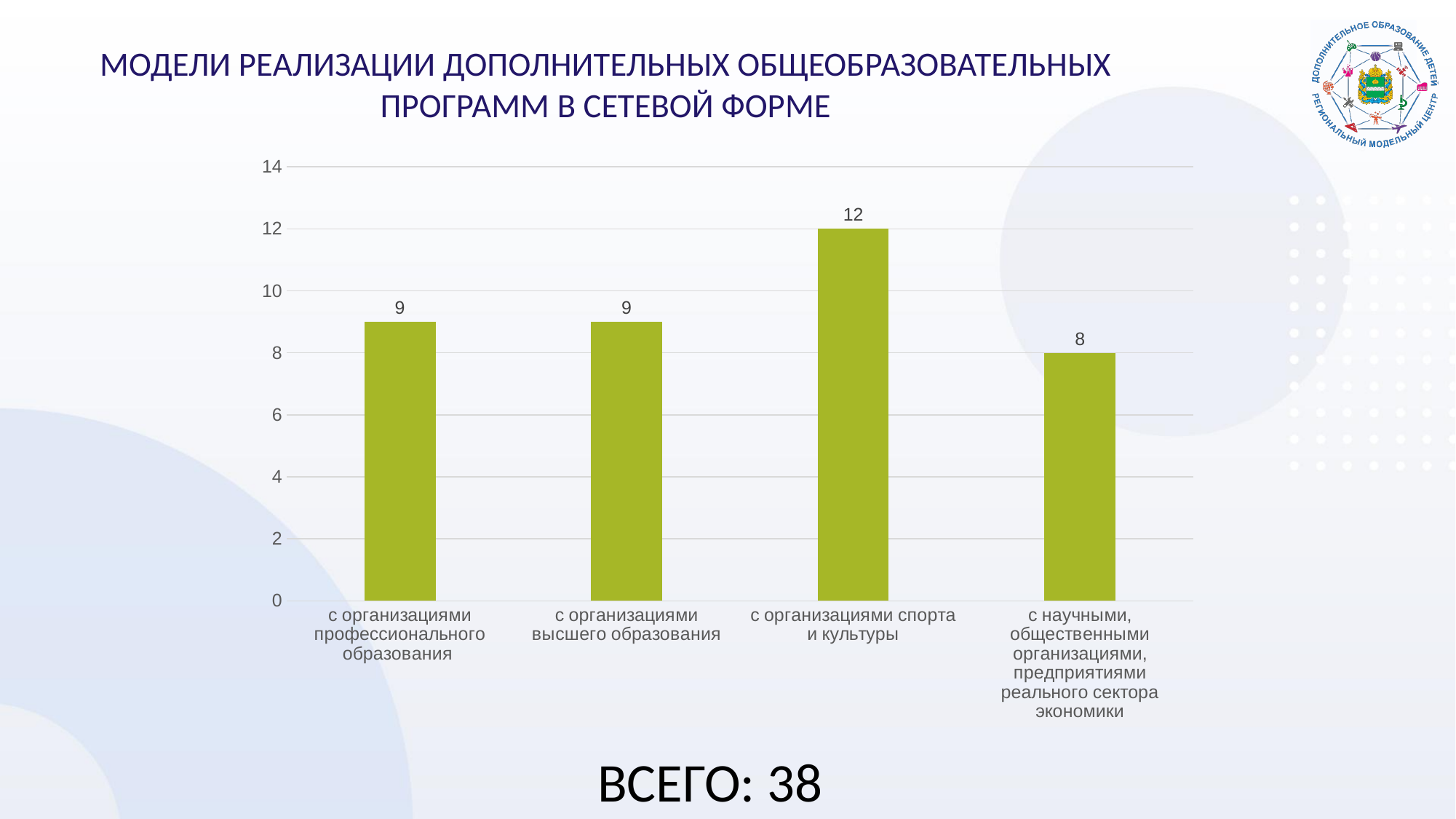
Which category has the highest value? с организациями спорта и культуры What kind of chart is shown on the slide? bar chart What is the maximum value shown on the vertical axis? 14 Which is larger: the value for 'с организациями спорта и культуры' or the value for 'с научными, общественными организациями, предприятиями реального сектора экономики'? с организациями спорта и культуры What is the value for 'с организациями спорта и культуры'? 12 What total is stated below the chart? ВСЕГО: 38 What is the value for 'с научными, общественными организациями, предприятиями реального сектора экономики'? 8 Is the value for 'с организациями спорта и культуры' greater or less than 10? greater What is the value for 'с организациями высшего образования'? 9 Which category has the lowest value? с научными, общественными организациями, предприятиями реального сектора экономики How many categories are shown in the chart? 4 What is the difference between the values for 'с организациями спорта и культуры' and 'с организациями профессионального образования'? 3